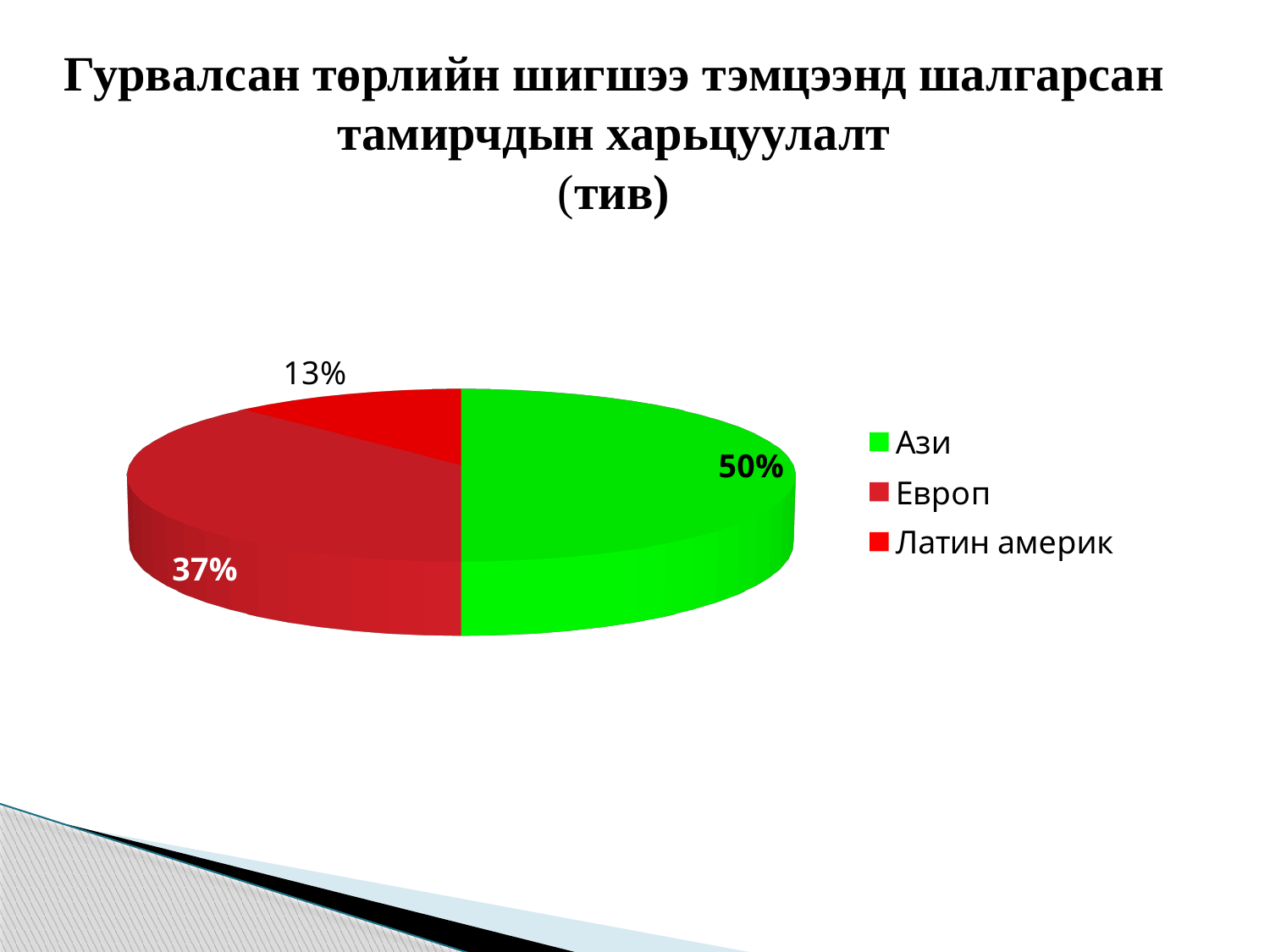
What share of the pie does Ази have? 50% What colour is the Ази slice? Green What kind of chart is shown on the slide? Pie chart Which category has the smallest slice of the pie? Латин америк What share of the pie does Латин америк have? 13% How many slices does the pie chart have? 3 How many entries does the legend list? 3 What is the difference in percentage points between the Ази and Европ slices? 13 What is the difference in percentage points between the Европ and Латин америк slices? 24 What share of the pie does Европ have? 37% Which category has the largest slice of the pie? Ази Which slice is larger, Европ or Латин америк? Европ